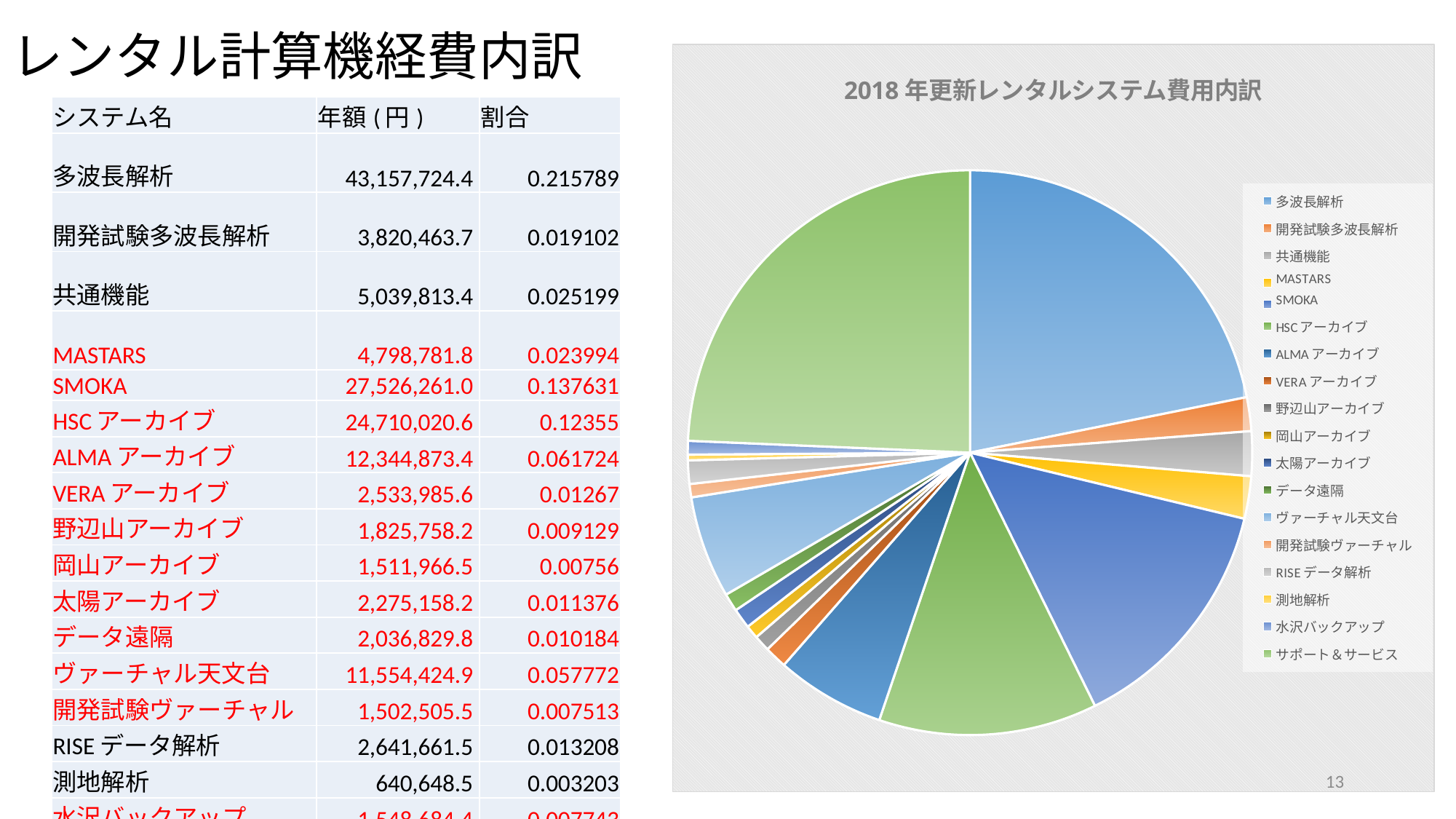
How many entries does the pie chart's legend list? 18 What kind of chart is shown on the slide? pie chart Which legend entry is listed first in the pie chart's legend? 多波長解析 Which system has the smallest slice in the pie chart? 測地解析 According to the table, what is the 年額 (円) for HSC アーカイブ? 24,710,020.6 According to the table, what is the 割合 for SMOKA? 0.137631 According to the table, what is the 割合 for ヴァーチャル天文台? 0.057772 Which slice of the pie chart is larger, 多波長解析 or SMOKA? 多波長解析 According to the table, what is the 年額 (円) for 多波長解析? 43,157,724.4 What is the title of the pie chart? 2018 年更新レンタルシステム費用内訳 What is the difference in 年額 (円) between 多波長解析 and SMOKA, using the table values? 15,631,463.4 Which slice of the pie chart is larger, ALMA アーカイブ or VERA アーカイブ? ALMA アーカイブ